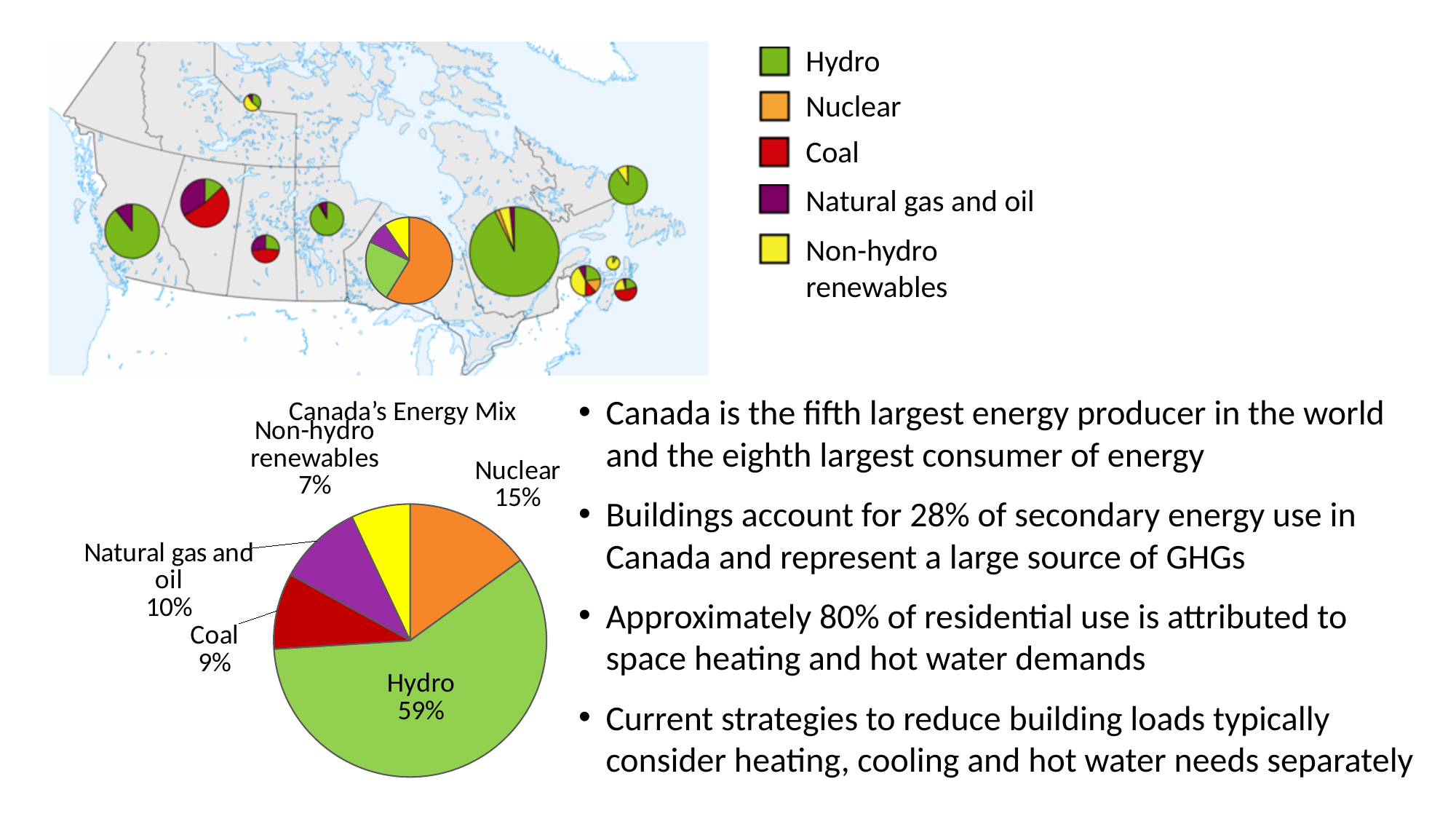
In the "Canada's Energy Mix" pie chart, what share do Non-hydro renewables have? 7% How many categories are shown in the "Canada's Energy Mix" pie chart? 5 In the "Canada's Energy Mix" pie chart, what share does Natural gas and oil have? 10% In the "Canada's Energy Mix" pie chart, what colour is the Coal slice? Red What kind of chart is "Canada's Energy Mix"? Pie chart In the "Canada's Energy Mix" pie chart, what share does Nuclear have? 15% In the "Canada's Energy Mix" pie chart, what share does Hydro have? 59% In the "Canada's Energy Mix" pie chart, what is the difference in percentage points between Hydro and Nuclear? 44 In the "Canada's Energy Mix" pie chart, which category has the smallest share? Non-hydro renewables In the "Canada's Energy Mix" pie chart, which category has the largest share? Hydro In the "Canada's Energy Mix" pie chart, what share does Coal have? 9% In the "Canada's Energy Mix" pie chart, which is larger, Coal or Natural gas and oil? Natural gas and oil